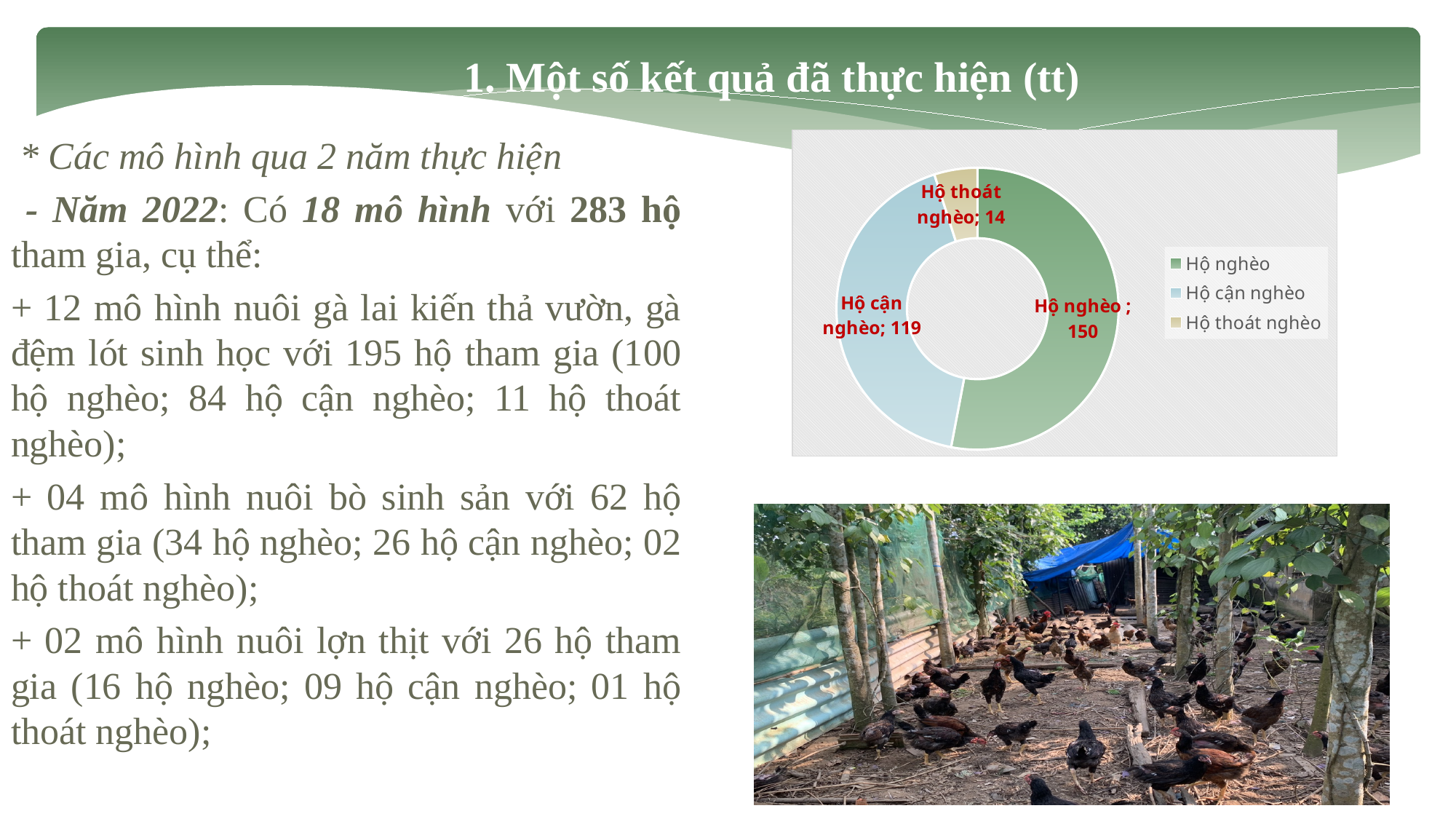
Which is larger, the value for Hộ cận nghèo or the value for Hộ thoát nghèo? Hộ cận nghèo What is the value for Hộ thoát nghèo in the doughnut chart? 14 Which colour represents Hộ cận nghèo in the doughnut chart? Light blue What is the value for Hộ nghèo in the doughnut chart? 150 Which category has the largest value in the doughnut chart? Hộ nghèo What kind of chart is shown on the slide? Doughnut chart What is the value for Hộ cận nghèo in the doughnut chart? 119 What is the total of all values shown in the doughnut chart? 283 How many categories does the doughnut chart show? 3 What is the difference between the values for Hộ cận nghèo and Hộ thoát nghèo? 105 Which category has the smallest value in the doughnut chart? Hộ thoát nghèo What is the difference between the values for Hộ nghèo and Hộ cận nghèo? 31